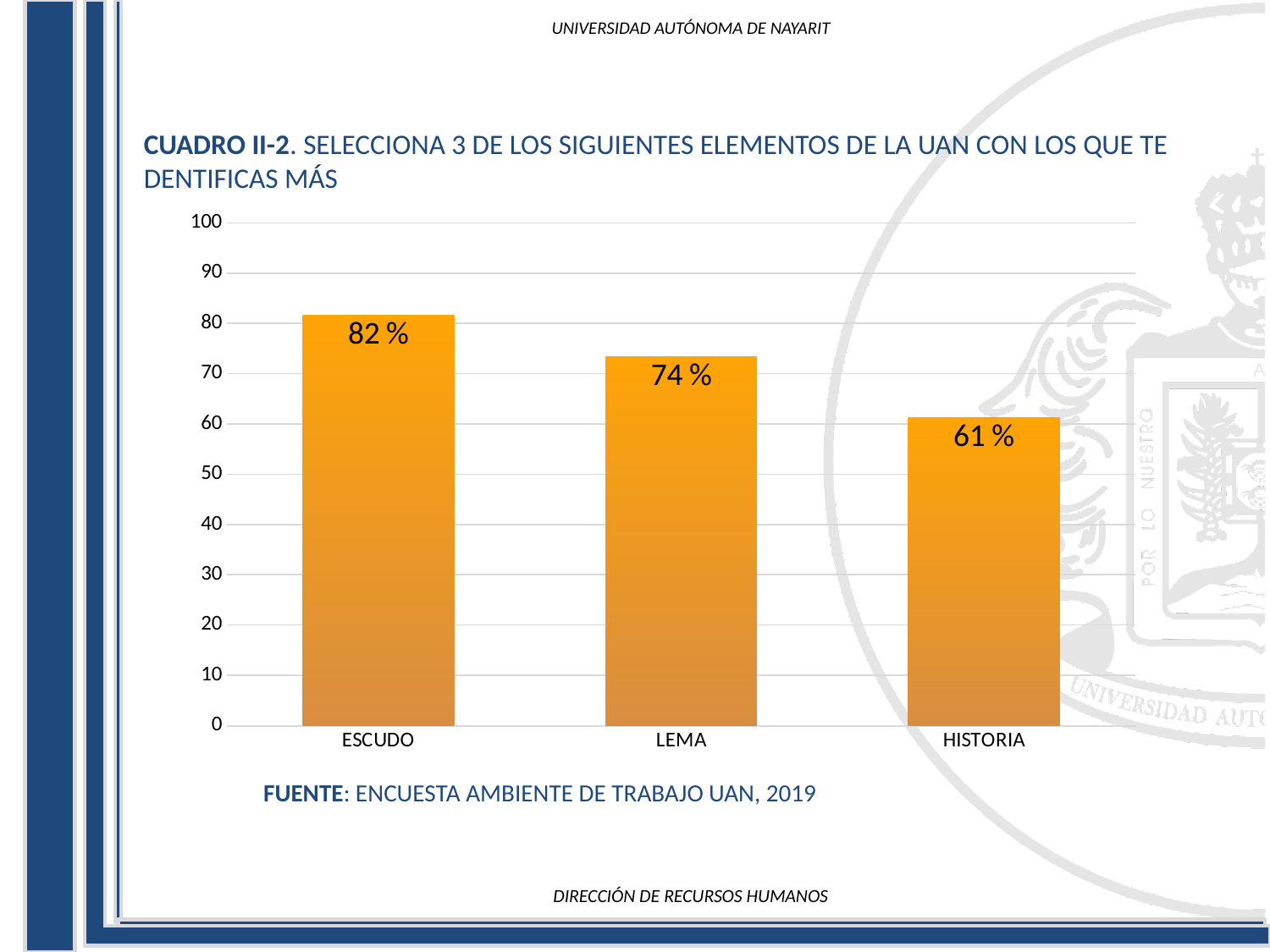
Which category has the lowest value? HISTORIA What is the difference between the values for ESCUDO and HISTORIA? 21 % Is the value for HISTORIA greater or less than 70? less What is the difference between the values for ESCUDO and LEMA? 8 % Which category has the highest value? ESCUDO What kind of chart is shown on the slide? bar chart Which is larger, the value for LEMA or the value for HISTORIA? LEMA Do the values rise or fall from left to right along the x axis? fall What is the value for HISTORIA? 61 % How many categories are shown on the x axis? 3 What is the value for ESCUDO? 82 % What is the value for LEMA? 74 %